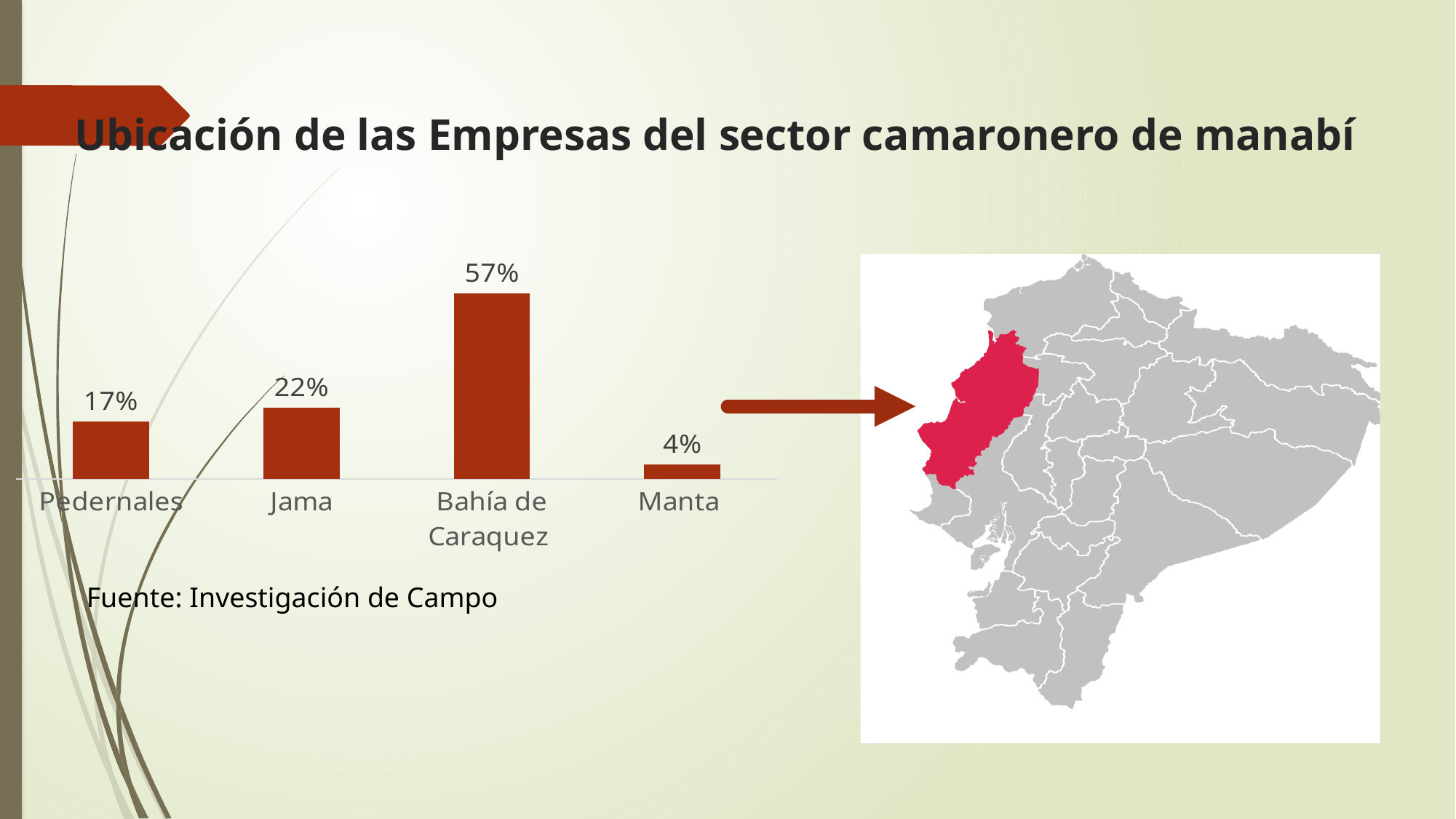
Which category has the lowest value? Manta Which category has the highest value? Bahía de Caraquez What is the value for Bahía de Caraquez? 57% What is the difference between the values for Jama and Pedernales? 5% What is the value for Pedernales? 17% What is the value for Jama? 22% What kind of chart is shown on the slide? Bar chart How many categories are shown in the bar chart? 4 Which is larger, the value for Jama or the value for Pedernales? Jama What is the difference between the values for Bahía de Caraquez and Jama? 35% What is the value for Manta? 4% What is the source cited below the chart? Investigación de Campo